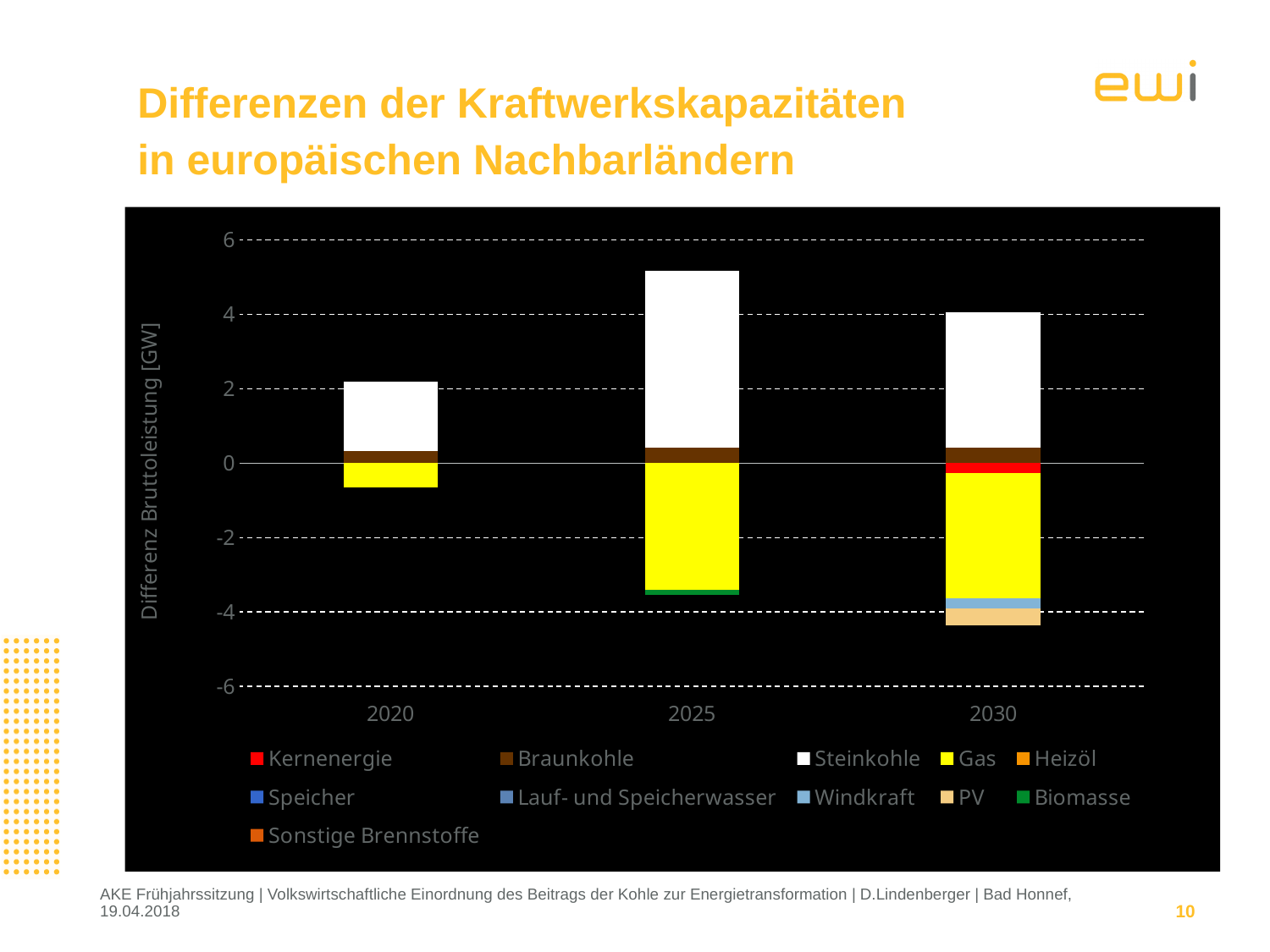
Is the bottom of the negative stack for 2025 greater or less than -2? less How many years (categories) are shown on the x axis of the chart? 3 Which year has the smallest positive (above zero) stacked bar? 2020 Is the top of the positive stack for 2030 greater or less than 2? greater Which year has the larger positive stacked bar, 2020 or 2030? 2030 What kind of chart is shown on the slide? stacked bar chart What is the label of the vertical axis of the chart? Differenz Bruttoleistung [GW] Is the top of the positive stack for 2020 greater or less than 4? less Which year has the tallest positive (above zero) stacked bar? 2025 How many series does the chart legend list? 11